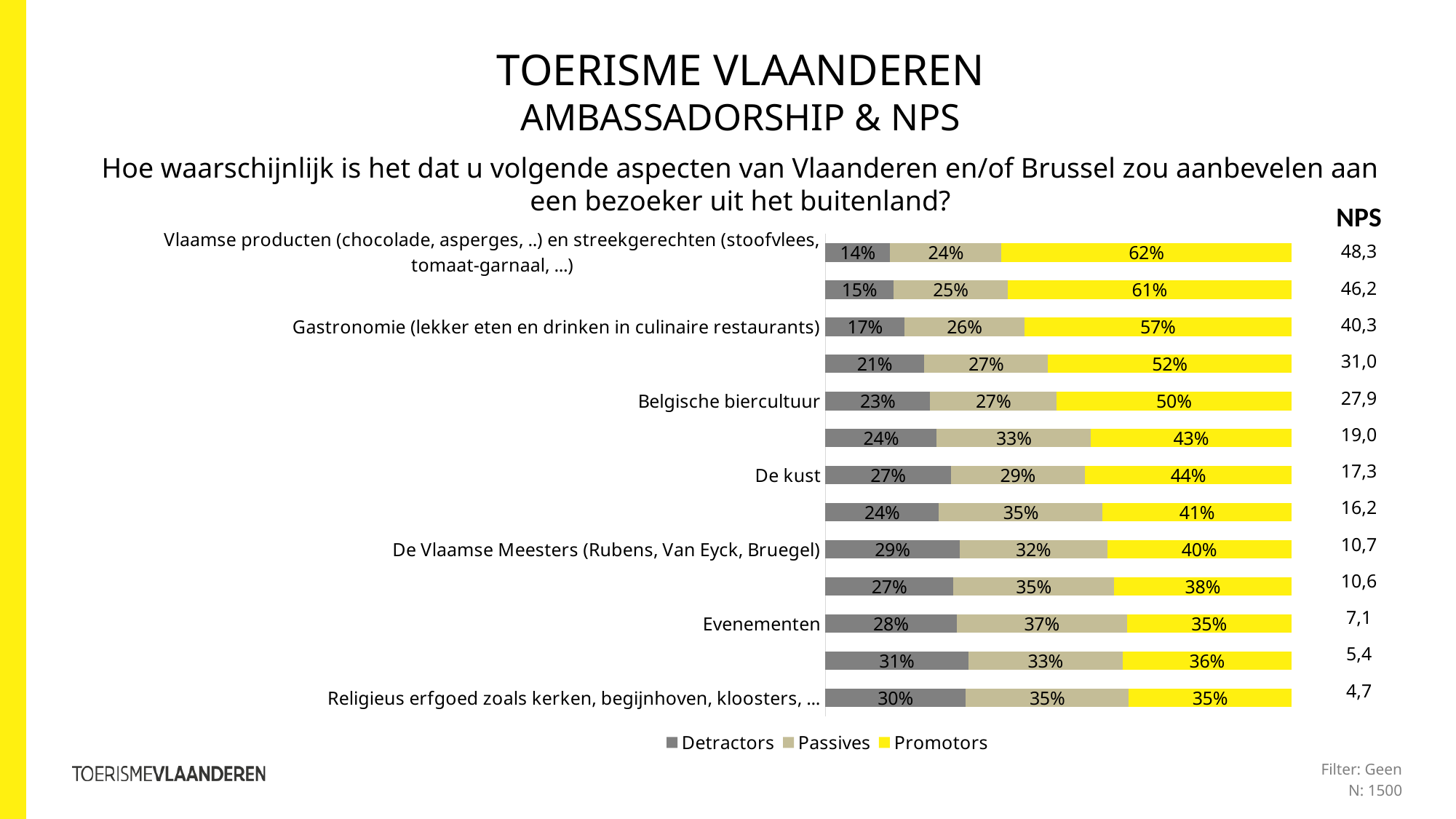
How many series does the legend list? 3 What is the NPS value shown for Religieus erfgoed zoals kerken, begijnhoven, kloosters, …? 4,7 Which labelled category has the highest Promotors percentage? Vlaamse producten (chocolade, asperges, ..) en streekgerechten (stoofvlees, tomaat-garnaal, …) What kind of chart is shown on the slide? Stacked bar chart What is the difference between the Promotors percentage for Vlaamse producten and for De Vlaamse Meesters (Rubens, Van Eyck, Bruegel)? 22% How many bars are plotted in the chart? 13 What percentage of Detractors is shown for De kust? 27% What percentage of Promotors is shown for Belgische biercultuur? 50% What is the NPS value shown for Gastronomie (lekker eten en drinken in culinaire restaurants)? 40,3 Which has a larger Detractors percentage: Belgische biercultuur or De Vlaamse Meesters (Rubens, Van Eyck, Bruegel)? De Vlaamse Meesters (Rubens, Van Eyck, Bruegel) Which labelled category has the lowest NPS value? Religieus erfgoed zoals kerken, begijnhoven, kloosters, … What percentage of Passives is shown for Evenementen? 37%